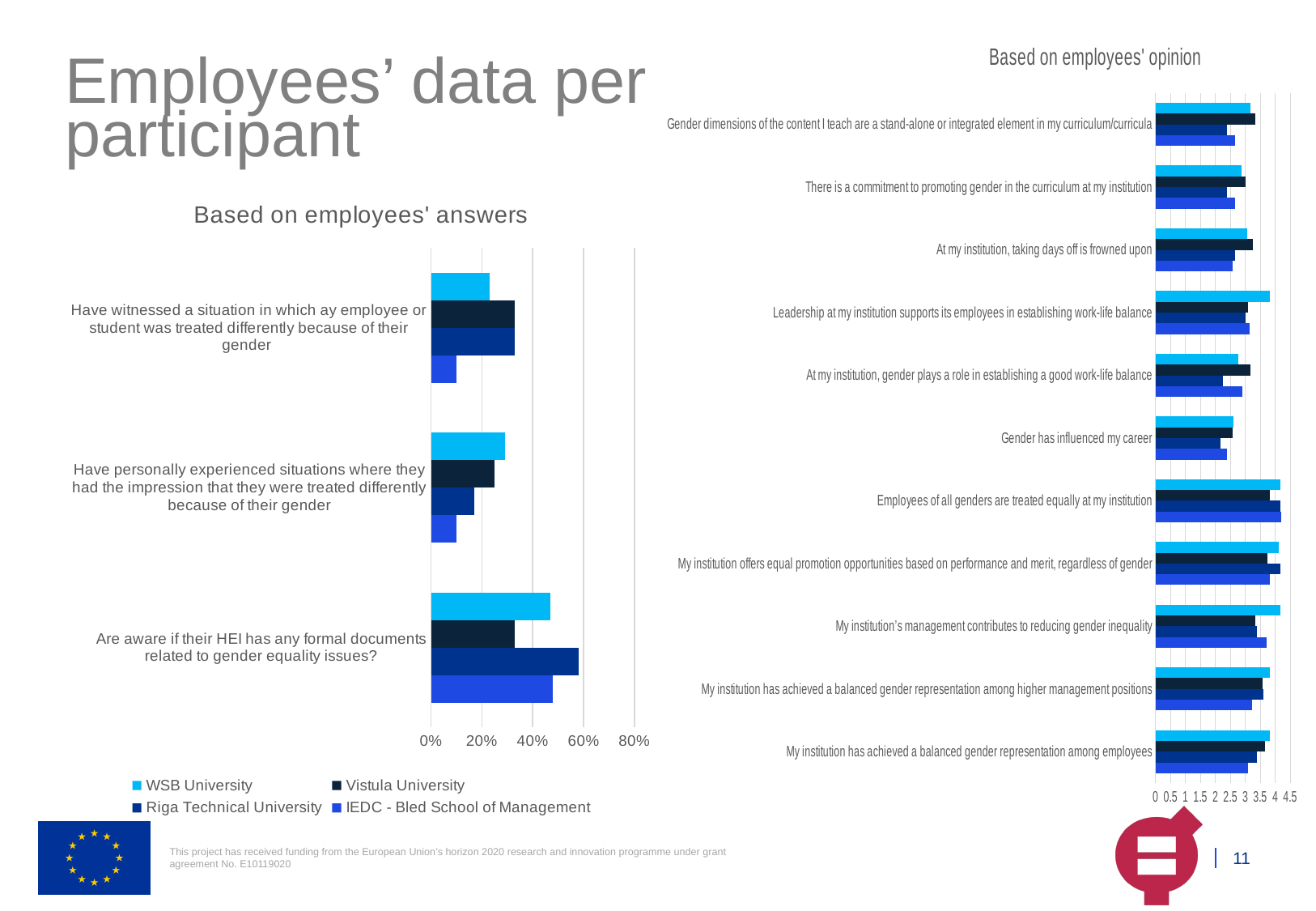
In the 'Based on employees' answers' chart, which university has the highest value for 'Are aware if their HEI has any formal documents related to gender equality issues?'? Riga Technical University How many categories (statements) are shown in the 'Based on employees' opinion' chart? 11 In the 'Based on employees' answers' chart, for 'Are aware if their HEI has any formal documents related to gender equality issues?', which is larger: Riga Technical University or Vistula University? Riga Technical University In the 'Based on employees' answers' chart, which university has the lowest value for 'Have witnessed a situation in which ay employee or student was treated differently because of their gender'? IEDC - Bled School of Management What kind of chart is the 'Based on employees' answers' chart? bar chart In the 'Based on employees' answers' chart, is the value for Riga Technical University on 'Are aware if their HEI has any formal documents related to gender equality issues?' greater or less than 40%? greater How many series does the legend of the 'Based on employees' answers' chart list? 4 In the 'Based on employees' answers' chart, is the value for IEDC - Bled School of Management on 'Have personally experienced situations where they had the impression that they were treated differently because of their gender' greater or less than 20%? less In the 'Based on employees' opinion' chart, are the values for 'Gender has influenced my career' greater or less than 3? less In the 'Based on employees' answers' chart, which series is shown in light blue? WSB University How many categories (questions) are shown in the 'Based on employees' answers' chart? 3 In the 'Based on employees' opinion' chart, which statement has the lowest values? Gender has influenced my career